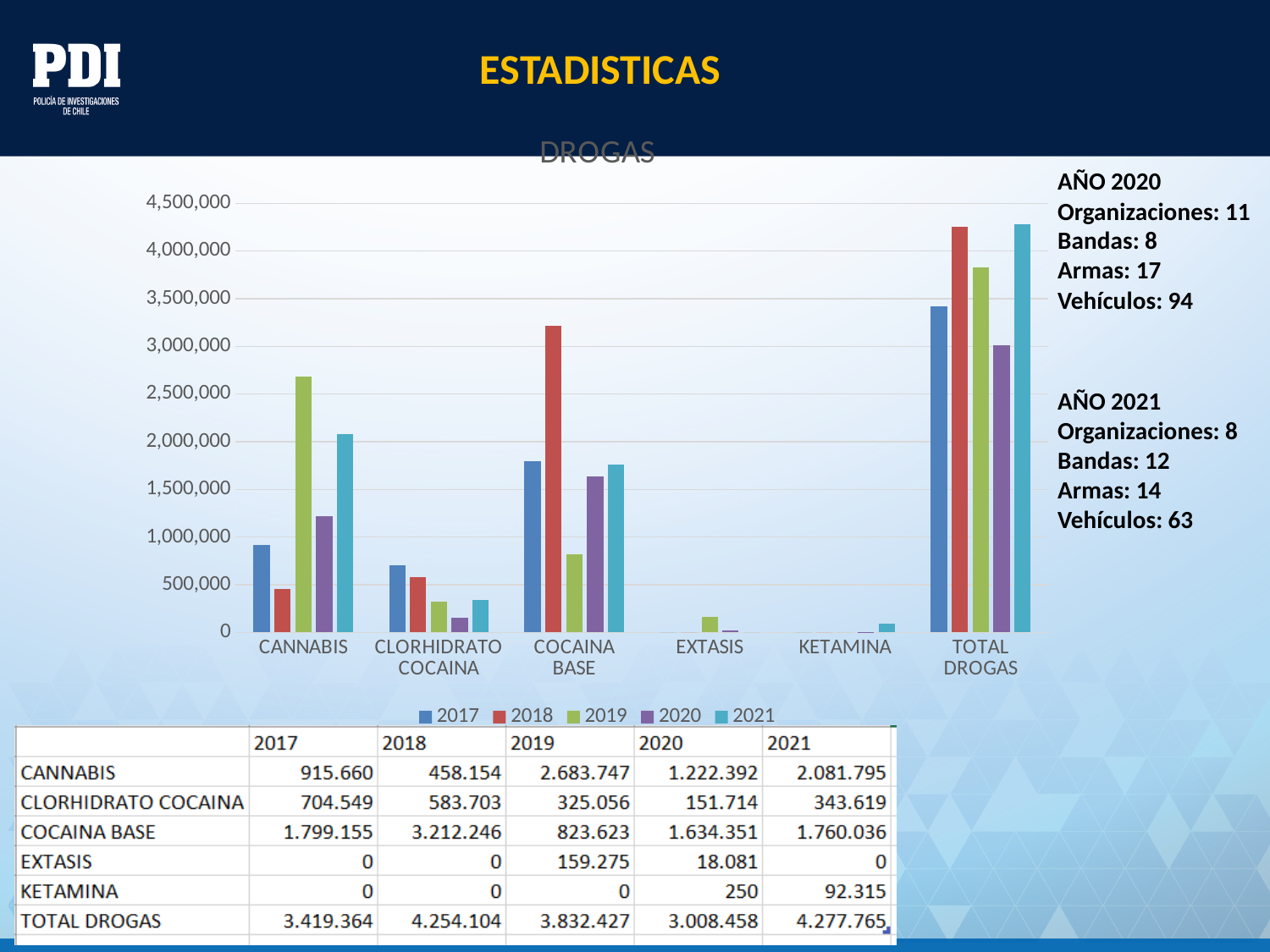
What is the value for TOTAL DROGAS in 2021? 4.277.765 Which is larger for CANNABIS: the 2019 value or the 2021 value? 2019 How many series does the legend list? 5 What is the value for CANNABIS in 2019? 2.683.747 What is the difference between the CANNABIS values for 2019 and 2017? 1.768.087 What kind of chart is shown on the slide? bar chart What is the title of the chart? DROGAS In which year is the value for COCAINA BASE highest? 2018 How many categories are shown on the x axis of the chart? 6 In which year is the value for TOTAL DROGAS lowest? 2020 What is the value for KETAMINA in 2020? 250 Is the value for COCAINA BASE in 2018 greater or less than 3,000,000? greater